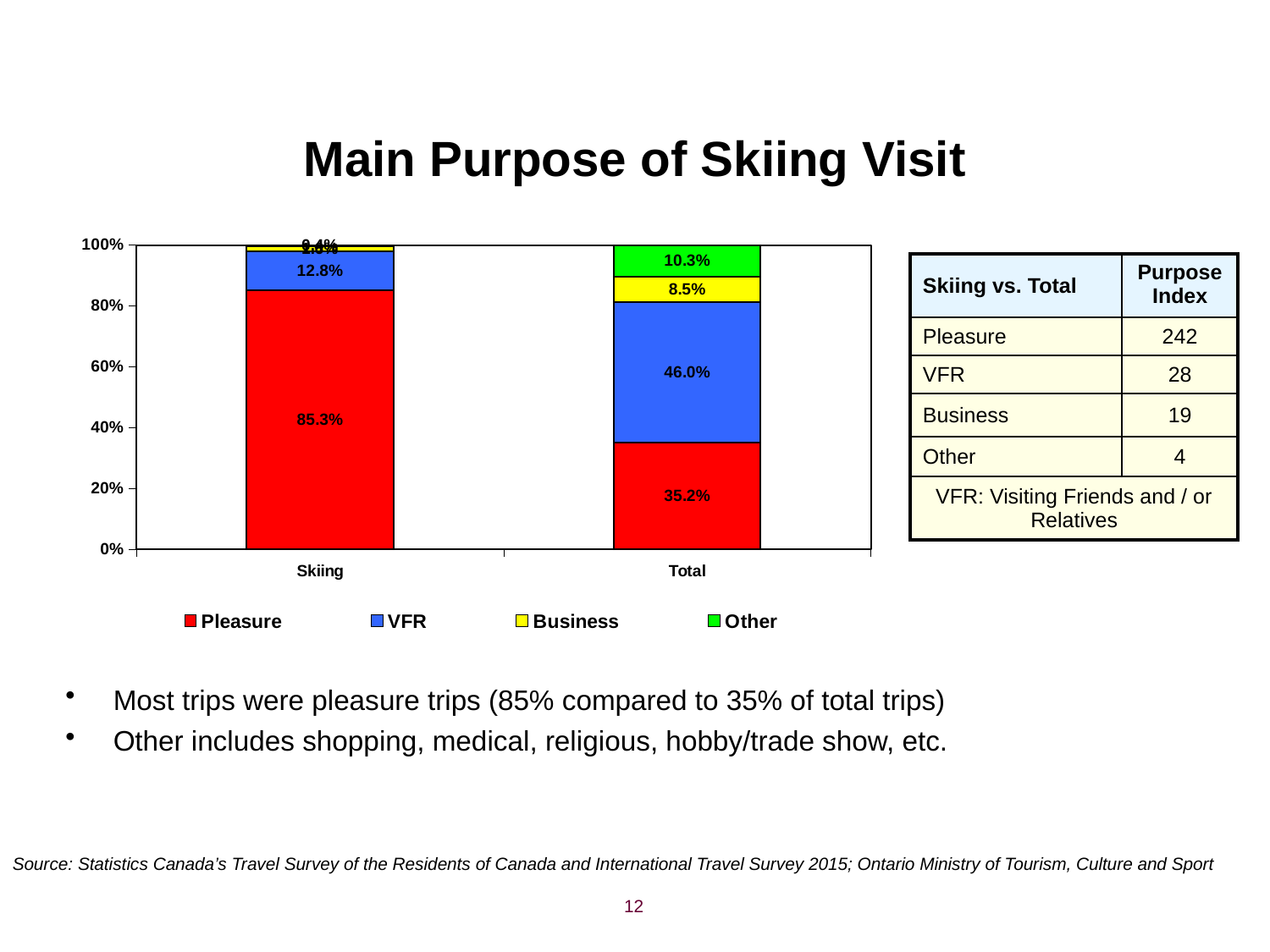
What kind of chart is shown on the slide? Stacked bar chart What is the value for VFR in the Skiing bar? 12.8% Which purpose has the largest share in the Total bar? VFR What is the title of the chart? Main Purpose of Skiing Visit Which has the larger VFR share, Skiing or Total? Total What is the difference between the Pleasure share for Skiing and the Pleasure share for Total? 50.1 percentage points What is the value for Pleasure in the Total bar? 35.2% What is the value for VFR in the Total bar? 46.0% What is the value for Business in the Total bar? 8.5% How many series does the legend list? 4 What is the value for Other in the Total bar? 10.3% What is the value for Pleasure in the Skiing bar? 85.3%